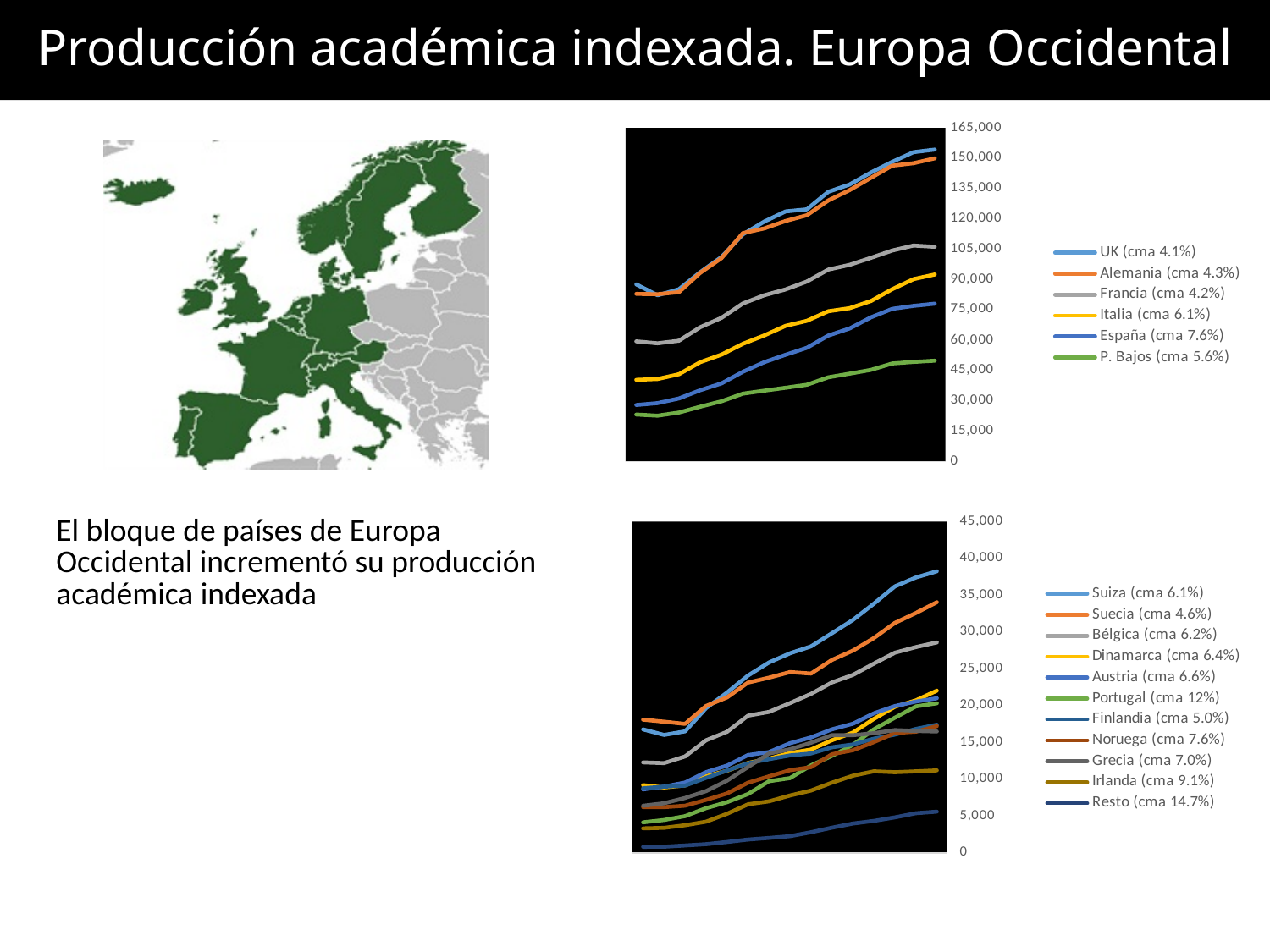
In the top chart, is the final value for UK greater or less than 135,000? greater In the bottom chart, which series has the highest value at the right end of the chart? Suiza (cma 6.1%) In the top chart, does the UK series rise or fall from left to right? rise In the bottom chart, what cma percentage does the legend give for Portugal? 12% What kind of chart is the top chart on the slide? line chart How many series does the legend of the bottom chart list? 11 How many series does the legend of the top chart list? 6 In the bottom chart, is the final value for Bélgica greater or less than 25,000? greater In the top chart, which series has the lowest value at the right end of the chart? P. Bajos (cma 5.6%) In the bottom chart, which series has the lowest value at the right end of the chart? Resto (cma 14.7%) In the top chart, which series has the highest value at the right end of the chart? UK (cma 4.1%) In the top chart, is the final value for P. Bajos greater or less than 60,000? less